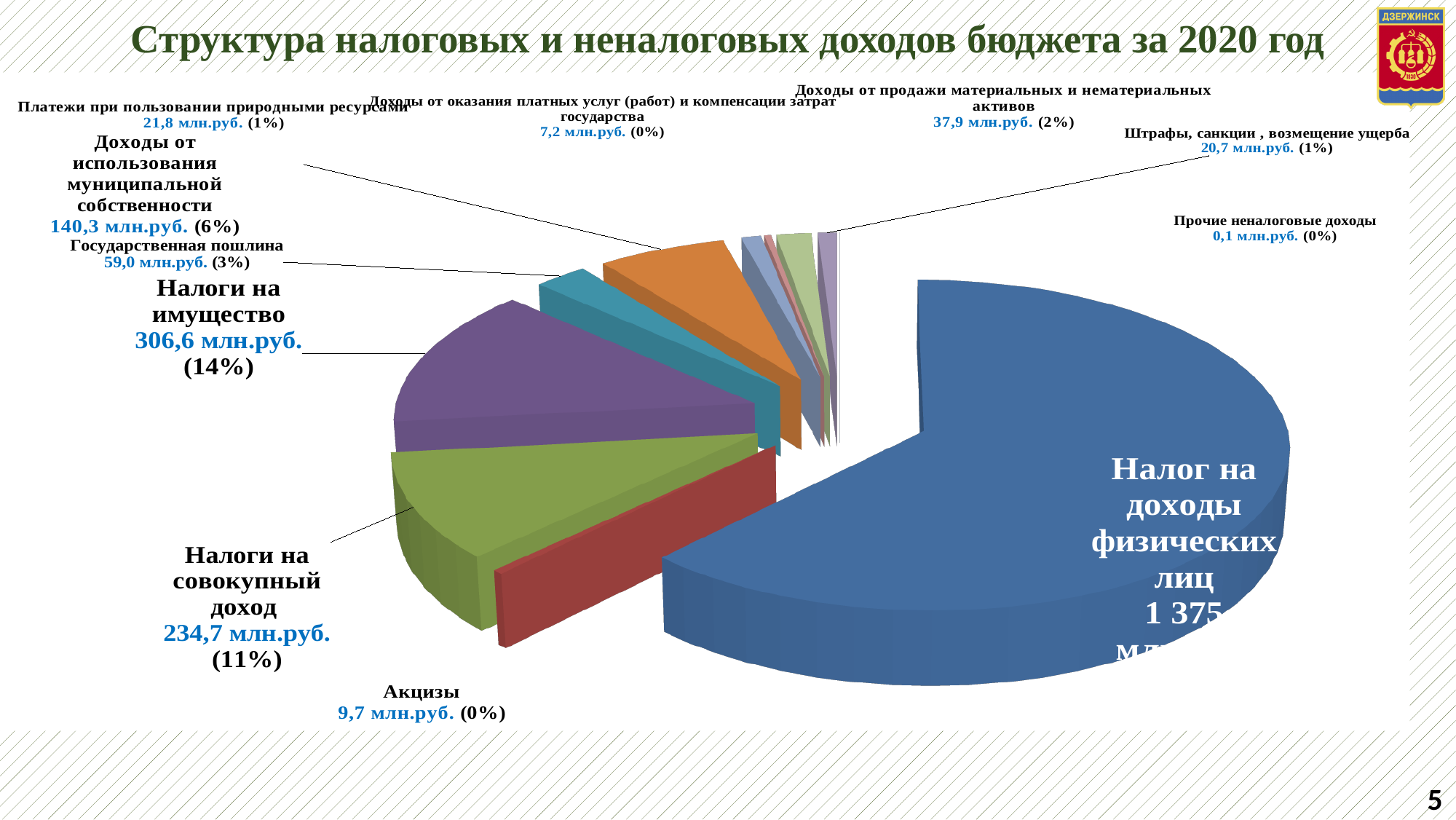
What is the value for Налоги на имущество? 306,6 млн.руб. What is the value for Государственная пошлина? 59,0 млн.руб. How many categories are shown in the pie chart? 11 Which is larger: Доходы от использования муниципальной собственности or Государственная пошлина? Доходы от использования муниципальной собственности What kind of chart is shown on the slide? Pie chart What is the difference between Налоги на имущество and Налоги на совокупный доход? 71,9 млн.руб. What is the value for Доходы от продажи материальных и нематериальных активов? 37,9 млн.руб. Which category has the smallest value? Прочие неналоговые доходы What is the value for Акцизы? 9,7 млн.руб. What is the value for Налоги на совокупный доход? 234,7 млн.руб. What share of the pie does Налоги на имущество represent? 14% Which category has the largest slice of the pie? Налог на доходы физических лиц